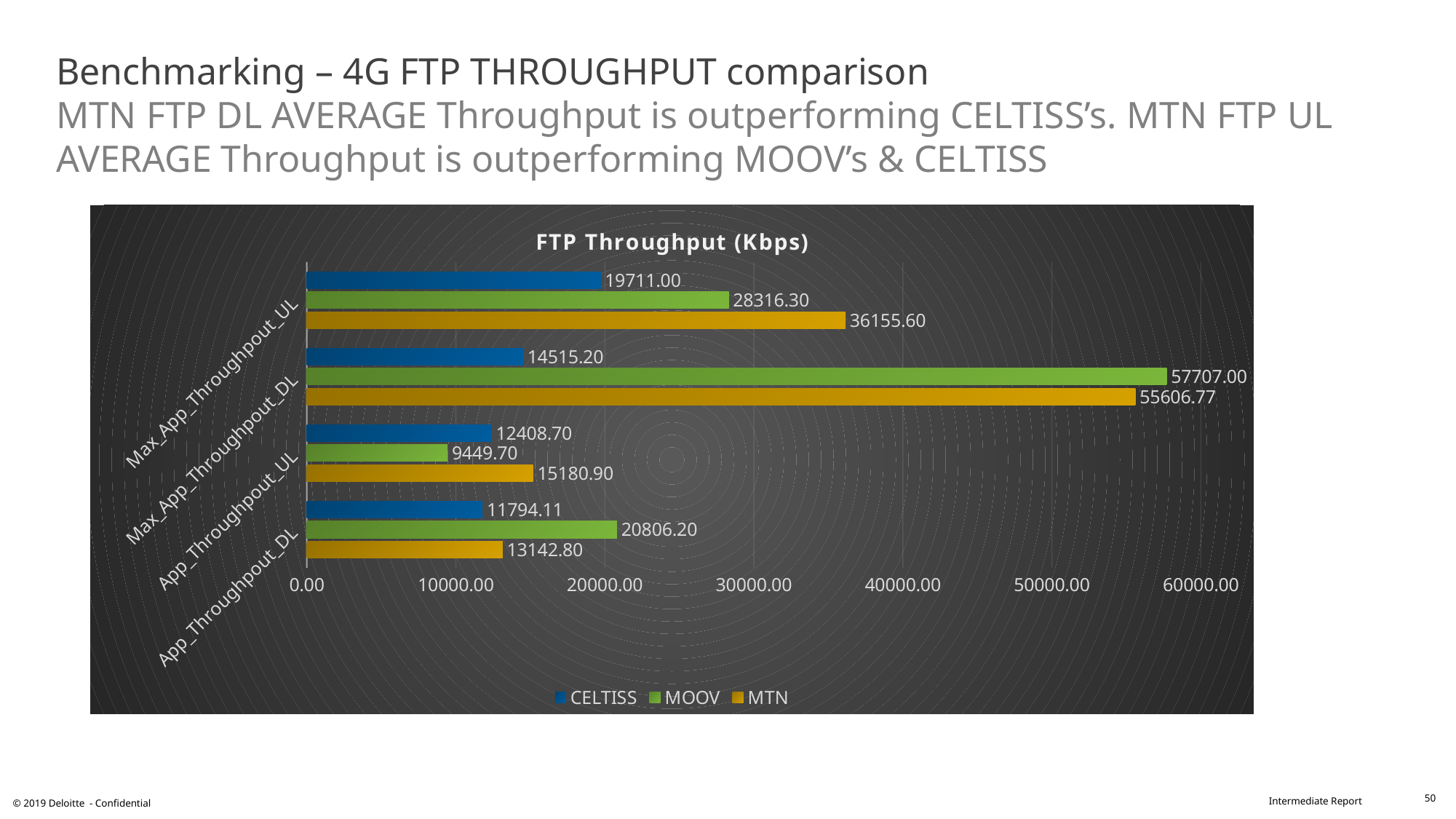
How many series does the legend list? 3 What is the MOOV value for App_Throughpout_UL? 9449.70 Is the CELTISS value for Max_App_Throughpout_DL greater or less than 20000.00? less Which operator has the highest value for Max_App_Throughpout_UL? MTN For App_Throughpout_DL, which is larger: the MOOV value or the MTN value? MOOV How many categories are shown on the vertical axis? 4 What type of chart is shown on the slide? Bar chart Which operator has the lowest value for App_Throughpout_UL? MOOV What is the difference between the MOOV and MTN values for Max_App_Throughpout_DL? 2100.23 What is the MTN value for Max_App_Throughpout_UL? 36155.60 What is the CELTISS value for App_Throughpout_DL? 11794.11 What is the MOOV value for Max_App_Throughpout_DL? 57707.00